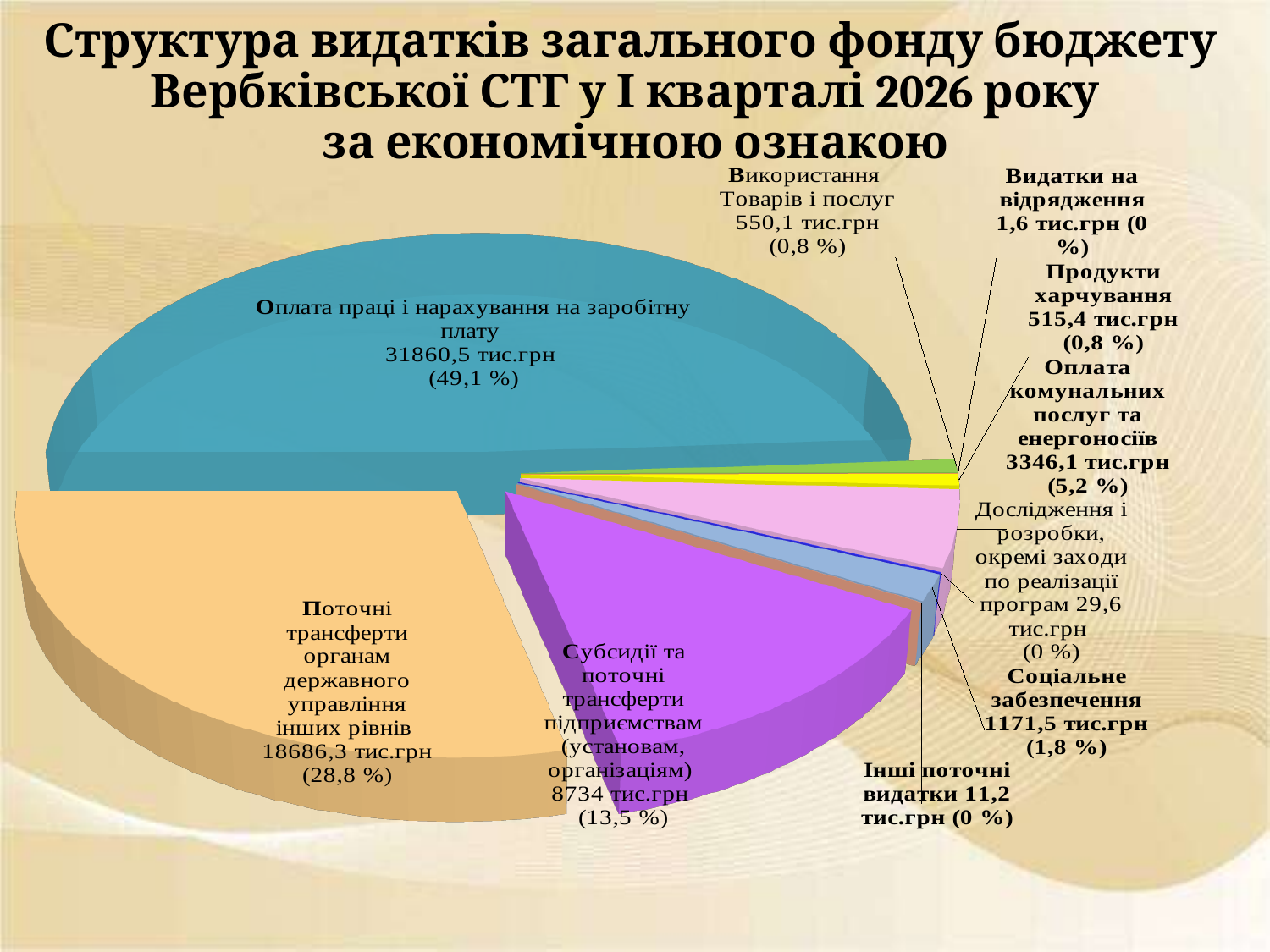
Which category has the largest value? Оплата праці і нарахування на заробітну плату What is the value for Оплата комунальних послуг та енергоносіїв? 3346,1 тис.грн What is the title of the chart? Структура видатків загального фонду бюджету Вербківської СТГ у І кварталі 2026 року за економічною ознакою What is the value for Оплата праці і нарахування на заробітну плату? 31860,5 тис.грн What is the value for Поточні трансферти органам державного управління інших рівнів? 18686,3 тис.грн What is the difference between Оплата праці і нарахування на заробітну плату and Поточні трансферти органам державного управління інших рівнів? 13174,2 тис.грн What share of the pie does Субсидії та поточні трансферти підприємствам (установам, організаціям) represent? 13,5 % Which category has the smallest value? Видатки на відрядження Which is larger: Продукти харчування or Використання товарів і послуг? Використання товарів і послуг What share of the pie does Соціальне забезпечення represent? 1,8 % What kind of chart is shown on the slide? Pie chart How many categories (slices) does the pie chart show? 10